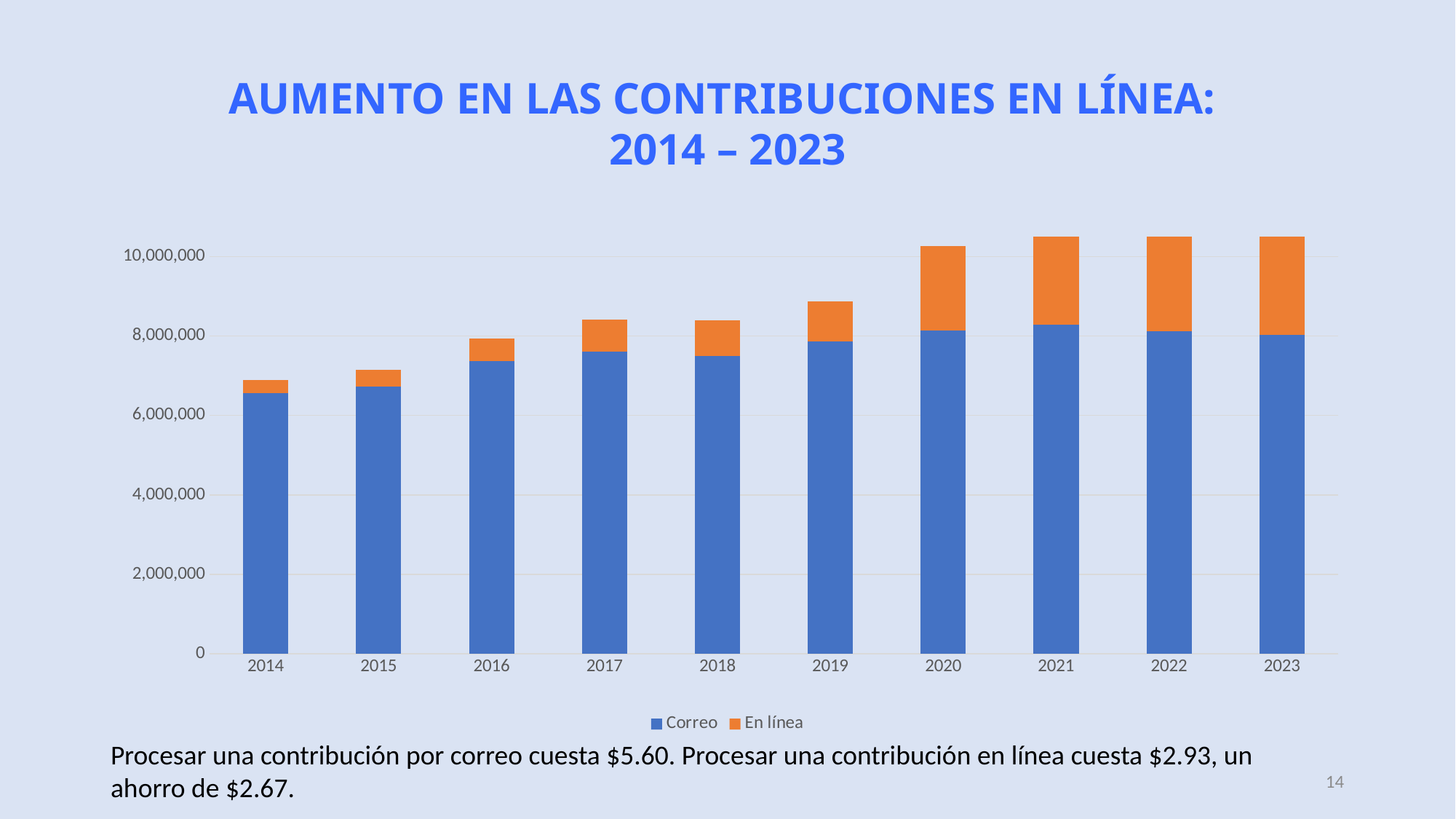
How many series does the chart legend list? 2 Which colour represents the 'En línea' series in the chart? Orange Which year has a larger total bar, 2015 or 2019? 2019 Is the total bar for 2019 greater or less than 10,000,000? less Is the 'Correo' value for 2016 greater or less than 8,000,000? less Is the total bar for 2020 greater or less than 10,000,000? greater Which year has the smallest 'En línea' segment? 2014 Which year has the lowest total contributions in the chart? 2014 What kind of chart is shown on the slide? Stacked bar chart How many years are shown on the x axis of the chart? 10 Do the total contributions generally rise or fall from 2014 to 2023? rise